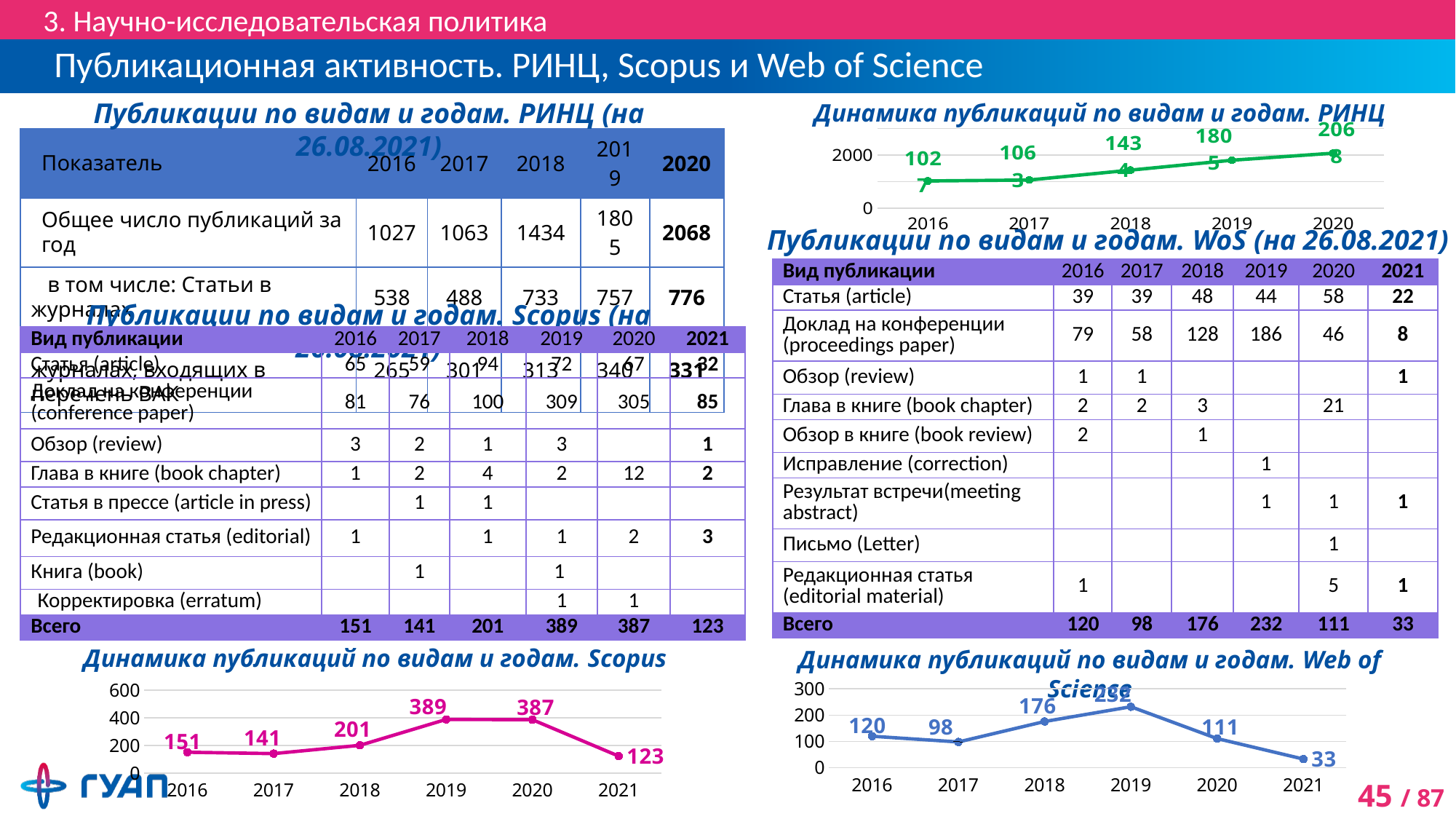
In the chart 'Динамика публикаций по видам и годам. Web of Science', which is larger, the value for 2016 or the value for 2017? 2016 In the chart 'Динамика публикаций по видам и годам. РИНЦ', is the value for 2016 greater or less than 2000? less What kind of chart is 'Динамика публикаций по видам и годам. РИНЦ'? line chart In the chart 'Динамика публикаций по видам и годам. Scopus', what is the value for 2021? 123 In the chart 'Динамика публикаций по видам и годам. Scopus', how many data points are plotted? 6 In the chart 'Динамика публикаций по видам и годам. Web of Science', do the values rise or fall from 2019 to 2021? fall In the chart 'Динамика публикаций по видам и годам. Web of Science', what is the difference between the values for 2019 and 2021? 199 In the chart 'Динамика публикаций по видам и годам. Web of Science', what is the value for 2018? 176 In the chart 'Динамика публикаций по видам и годам. Scopus', what is the difference between the values for 2019 and 2016? 238 In the chart 'Динамика публикаций по видам и годам. Web of Science', which year has the highest value? 2019 In the chart 'Динамика публикаций по видам и годам. Scopus', which year has the lowest value? 2021 In the chart 'Динамика публикаций по видам и годам. Scopus', what is the value for 2019? 389